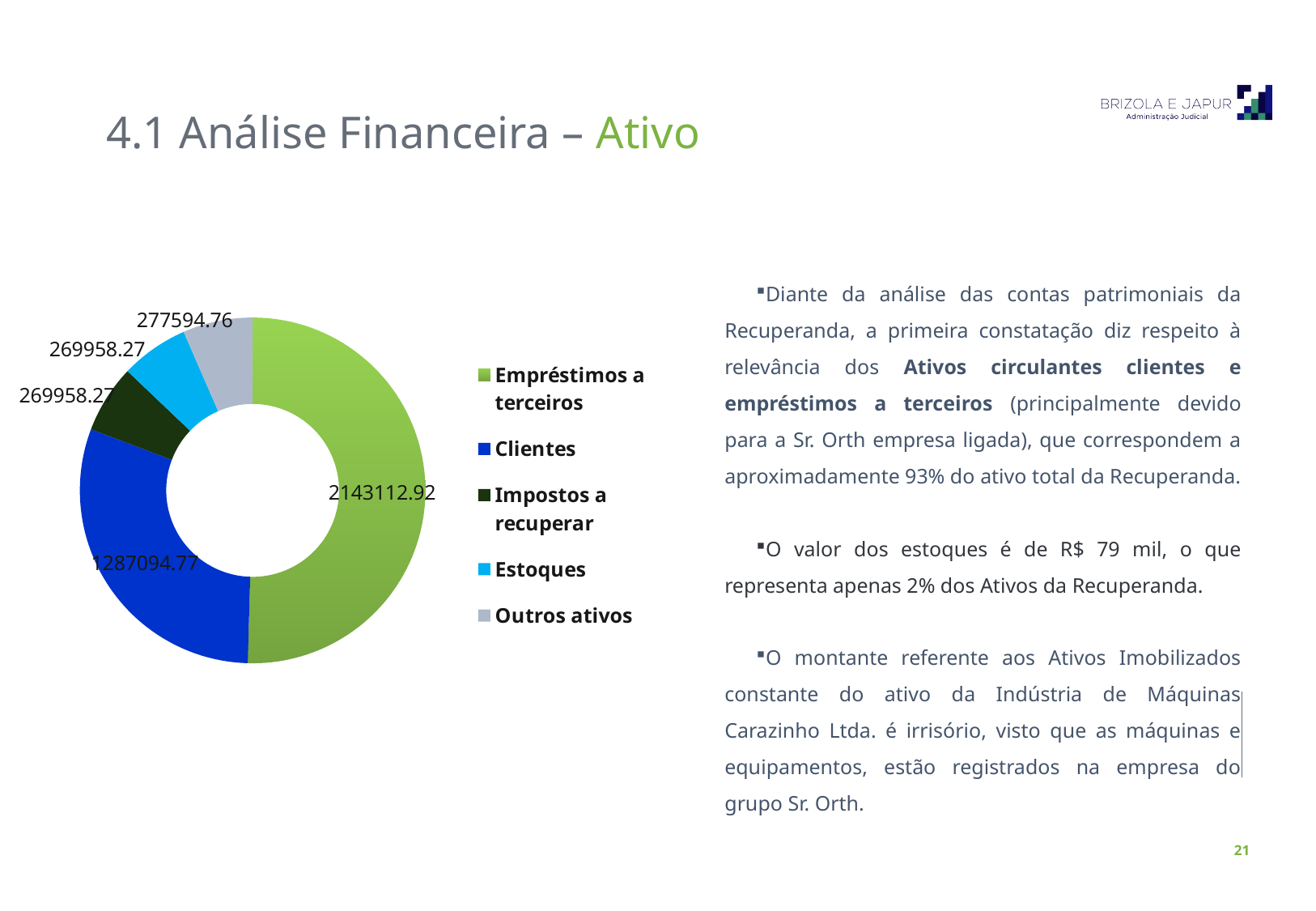
What kind of chart is shown on the slide? doughnut chart What value is shown for Estoques? 269958.27 What value is shown for Outros ativos? 277594.76 What value is shown for Clientes? 1287094.77 Which is larger, the value for Clientes or the value for Empréstimos a terceiros? Empréstimos a terceiros How many categories does the chart show? 5 What is the difference between the values for Empréstimos a terceiros and Clientes? 856018.15 Which legend entry is listed last? Outros ativos What colour is the slice for Clientes? blue What value is shown for Empréstimos a terceiros? 2143112.92 What is the difference between the values for Outros ativos and Estoques? 7636.49 Which category has the largest slice in the chart? Empréstimos a terceiros